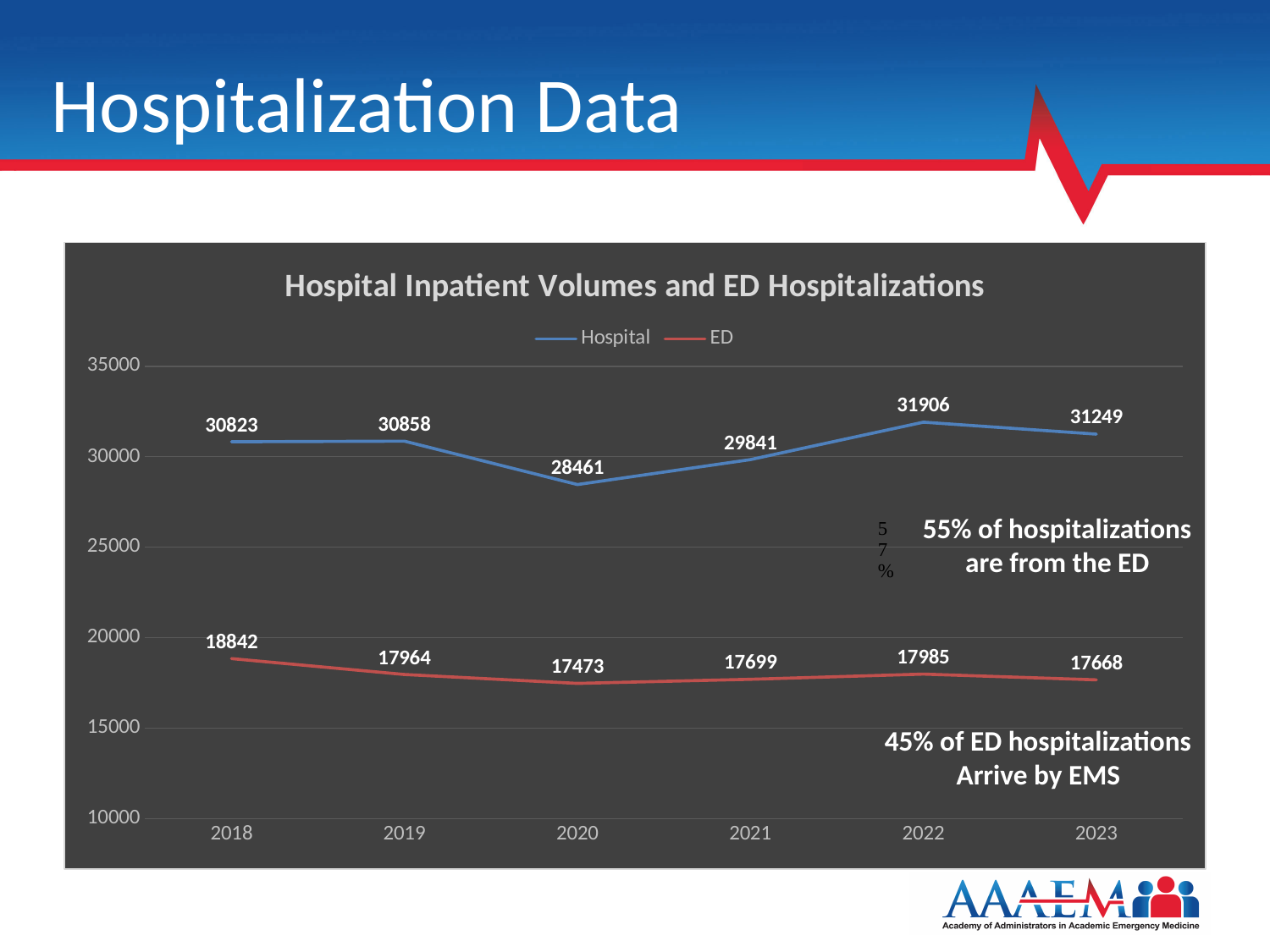
What is the difference between the Hospital and ED values in 2022? 13921 What kind of chart is shown? line chart What is the title of the chart? Hospital Inpatient Volumes and ED Hospitalizations What is the ED value for 2018? 18842 How many series does the legend list? 2 Which is larger, the Hospital value for 2019 or the Hospital value for 2021? 2019 Which year has the lowest ED value? 2020 What is the ED value for 2023? 17668 What is the Hospital value for 2020? 28461 Which year has the highest Hospital value? 2022 Is the ED value for 2021 greater or less than 20000? less How many years are shown on the x axis? 6